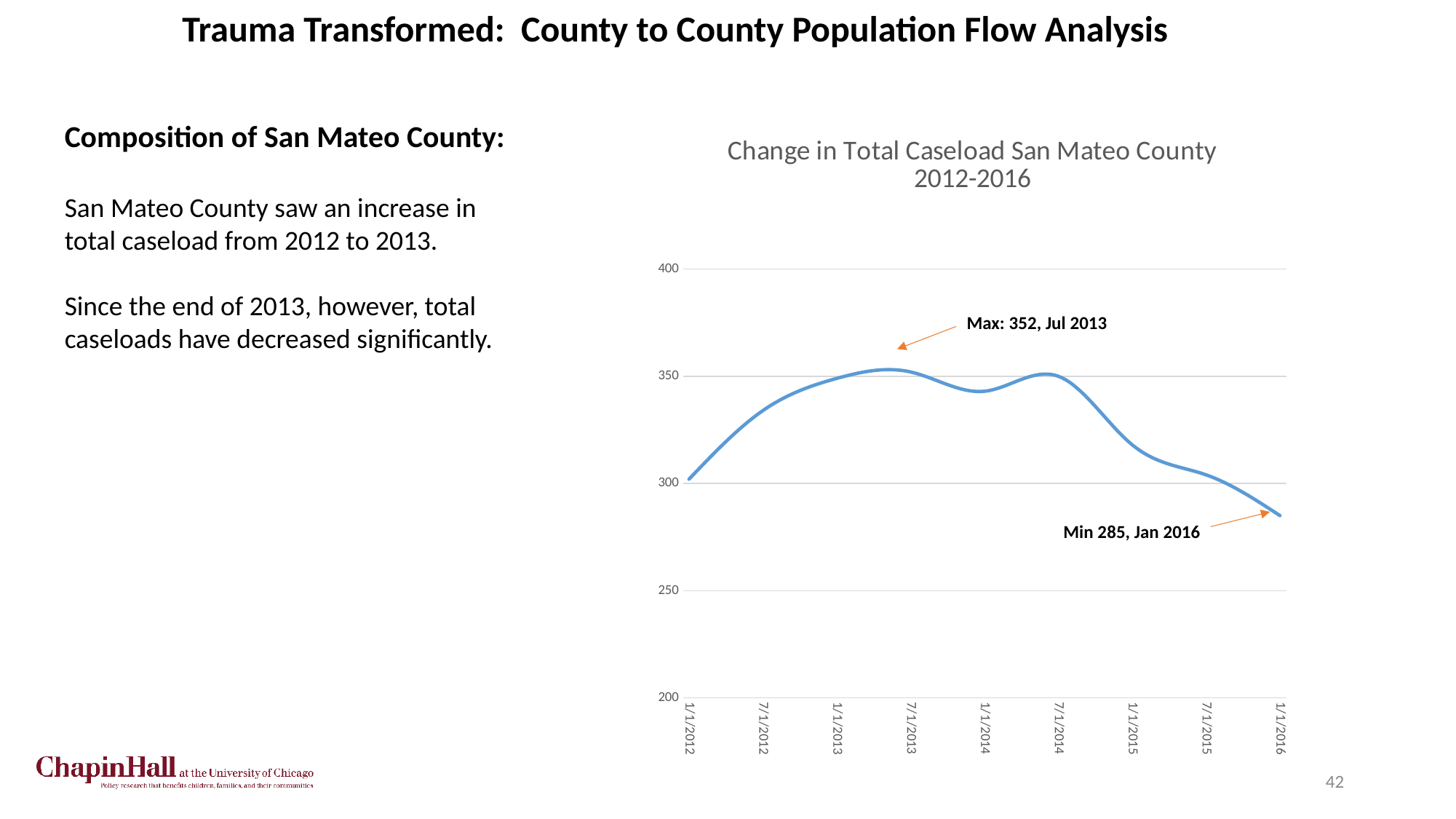
Is the value at 1/1/2015 greater or less than 350? less Is the value at 1/1/2014 greater or less than 350? less Is the value at 7/1/2012 greater or less than 300? greater Which is higher, the value at 1/1/2013 or the value at 1/1/2015? 1/1/2013 What kind of chart is shown on the slide? line chart What is the maximum total caseload value marked on the chart? 352 In which month and year does the chart mark the maximum caseload? Jul 2013 What is the minimum total caseload value marked on the chart? 285 Does the line rise or fall between 7/1/2014 and 1/1/2016? fall What is the difference between the marked maximum (352) and the marked minimum (285) caseload? 67 In which month and year does the chart mark the minimum caseload? Jan 2016 What is the title of the chart? Change in Total Caseload San Mateo County 2012-2016